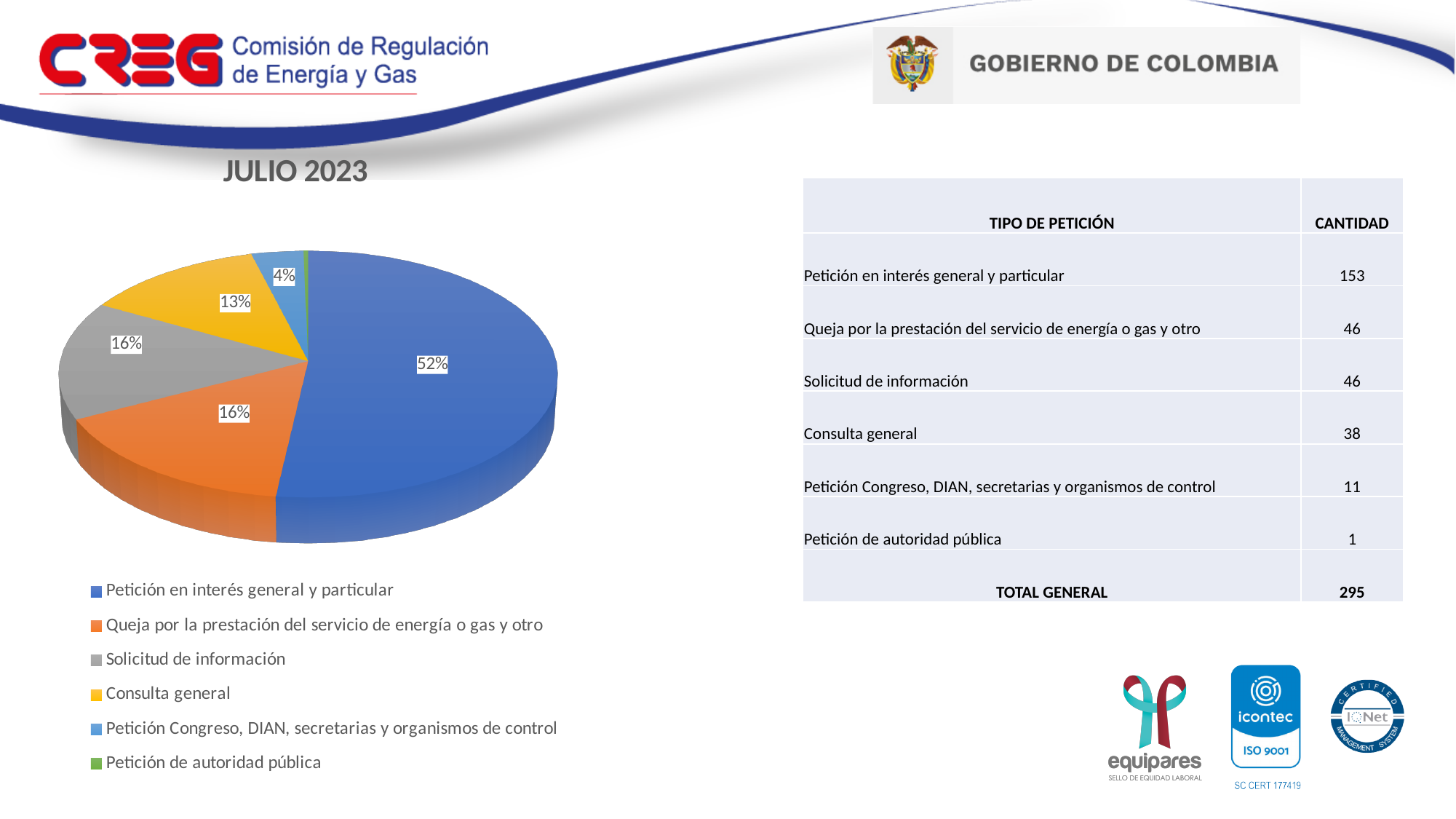
What share of the pie does 'Consulta general' represent? 13% What share of the pie does 'Queja por la prestación del servicio de energía o gas y otro' represent? 16% Which category has the largest slice of the pie? Petición en interés general y particular What share of the pie does 'Petición en interés general y particular' represent? 52% Which slice is larger: 'Consulta general' or 'Petición Congreso, DIAN, secretarias y organismos de control'? Consulta general What kind of chart is shown on the slide? pie chart What is the difference in percentage points between the 'Petición en interés general y particular' slice and the 'Consulta general' slice? 39 Which category has the smallest slice of the pie? Petición de autoridad pública What is the title of the pie chart? JULIO 2023 How many entries does the legend of the pie chart list? 6